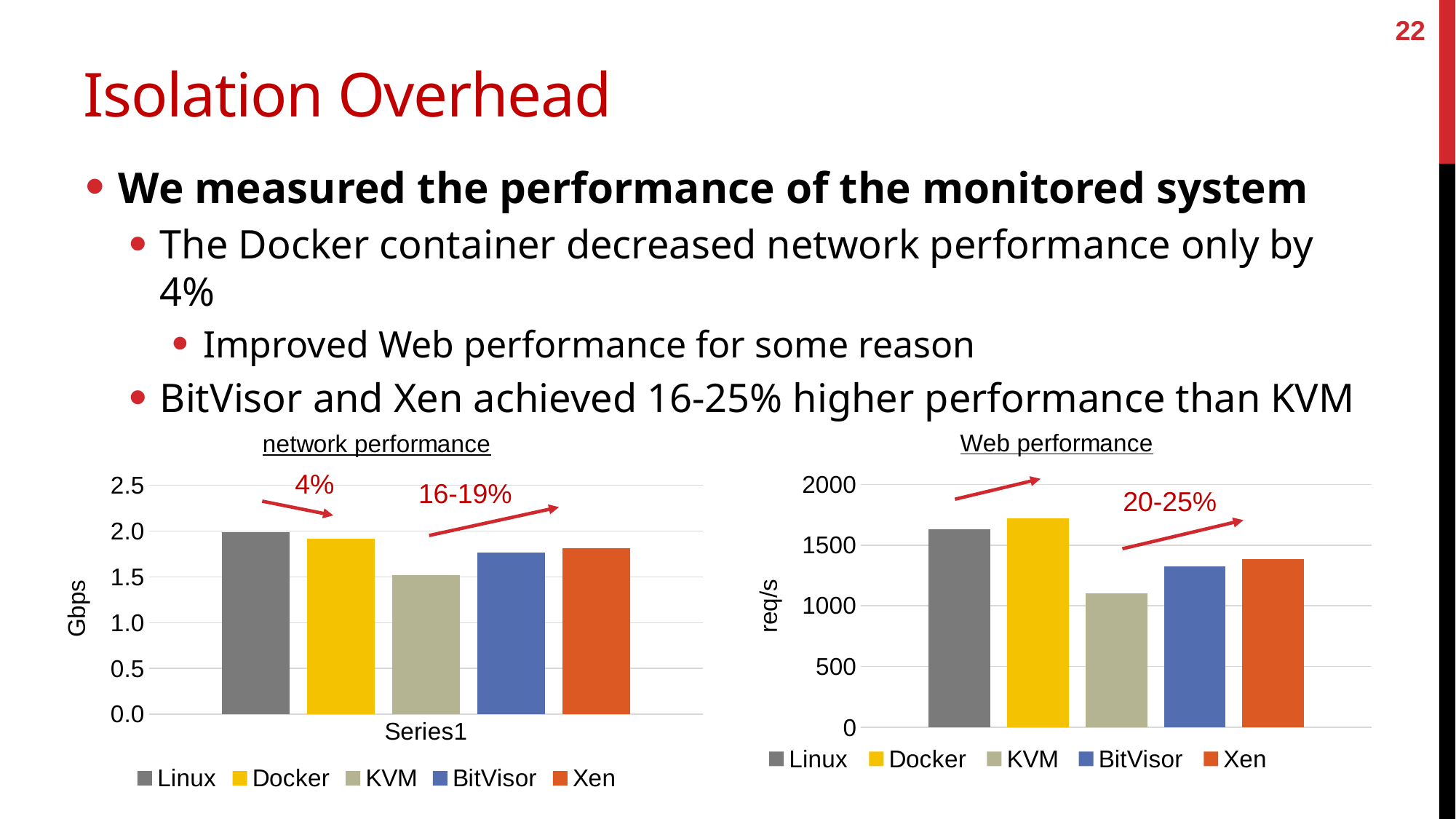
What kind of chart is the network performance chart? bar chart In the Web performance chart, which series has the highest value? Docker In the network performance chart, is the value for KVM greater or less than 2.0? less In the network performance chart, which is larger, the value for KVM or the value for BitVisor? BitVisor In the Web performance chart, is the value for Docker greater or less than 1500? greater In the network performance chart, is the value for Linux greater or less than 1.5? greater In the Web performance chart, which series has the lowest value? KVM In the network performance chart, which series has the lowest value? KVM In the Web performance chart, which is larger, the value for Linux or the value for KVM? Linux How many series does the legend of the Web performance chart list? 5 What is the y-axis label of the Web performance chart? req/s